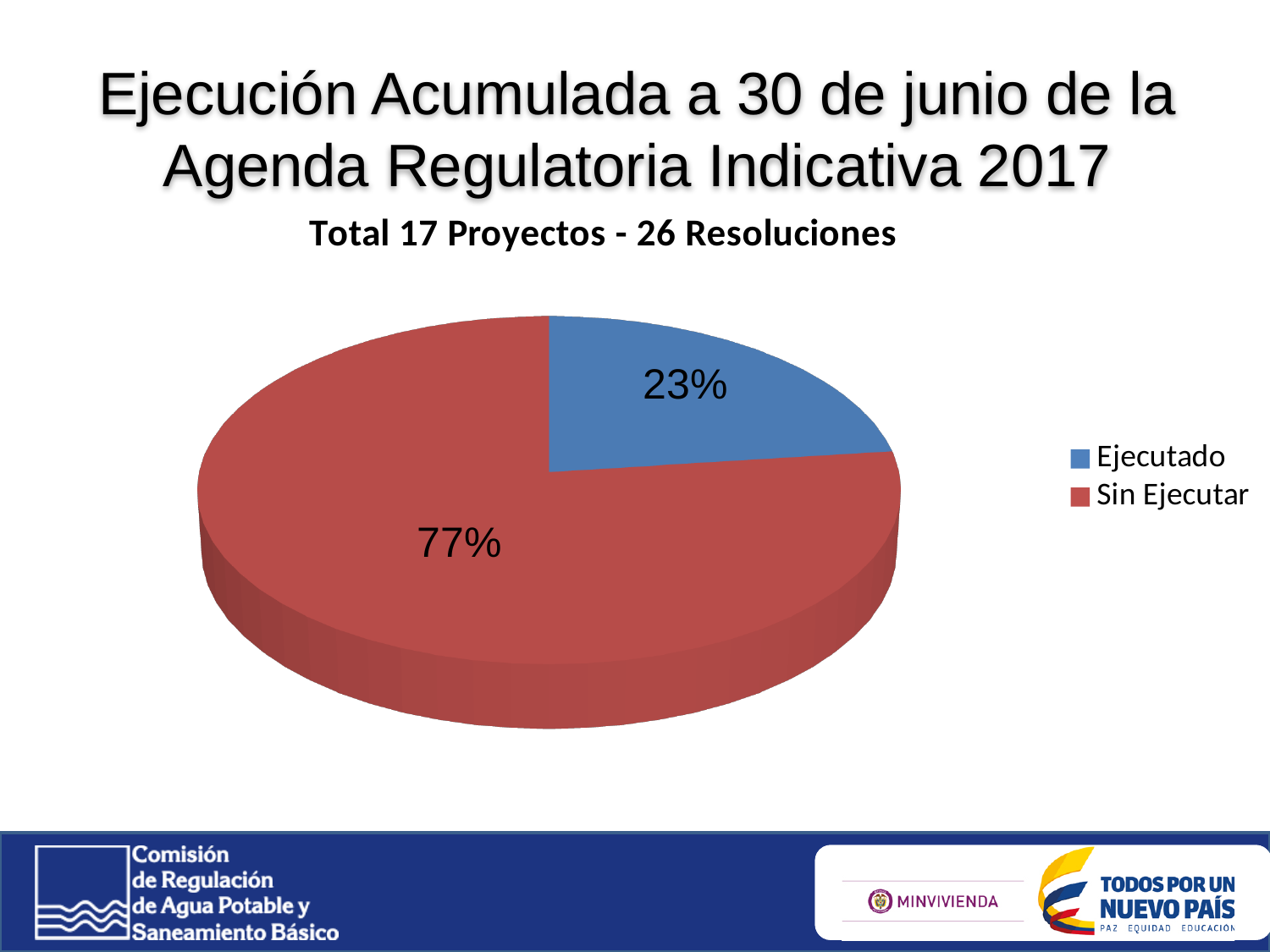
What share of the pie does Ejecutado represent? 23% Which slice is the largest in the pie chart? Sin Ejecutar Which is larger, Ejecutado or Sin Ejecutar? Sin Ejecutar What colour is the Ejecutado slice? Blue What is the title of the chart? Total 17 Proyectos - 26 Resoluciones How many entries does the legend list? 2 Which slice is the smallest in the pie chart? Ejecutado What kind of chart is shown on the slide? Pie chart What share of the pie does Sin Ejecutar represent? 77% How many slices does the pie chart have? 2 What is the difference in percentage points between Sin Ejecutar and Ejecutado? 54